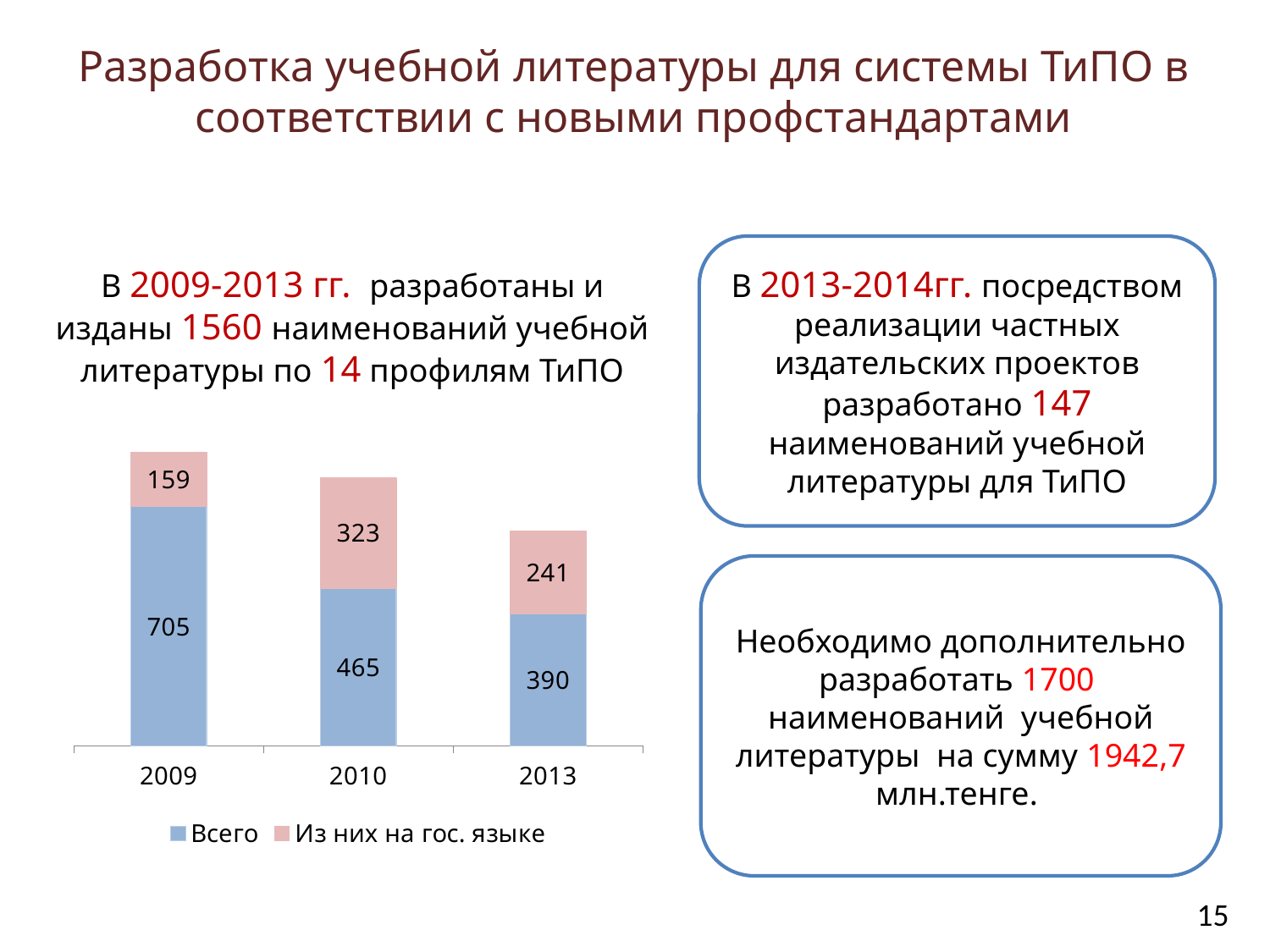
How many categories (years) are shown on the x axis of the chart? 3 Which is larger: the 'Из них на гос. языке' value for 2010 or for 2013? 2010 How many series does the chart legend list? 2 What is the value of the 'Из них на гос. языке' series for 2010? 323 What type of chart is shown on the slide? stacked bar chart What is the total of the stacked bar for 2010? 788 What is the value of the 'Всего' series for 2013? 390 What is the difference between the 'Всего' values for 2009 and 2013? 315 Does the 'Всего' series rise or fall from 2009 to 2013? fall What is the value of the 'Всего' series for 2009? 705 In which year is the 'Из них на гос. языке' value the lowest? 2009 In which year is the 'Всего' value the highest? 2009